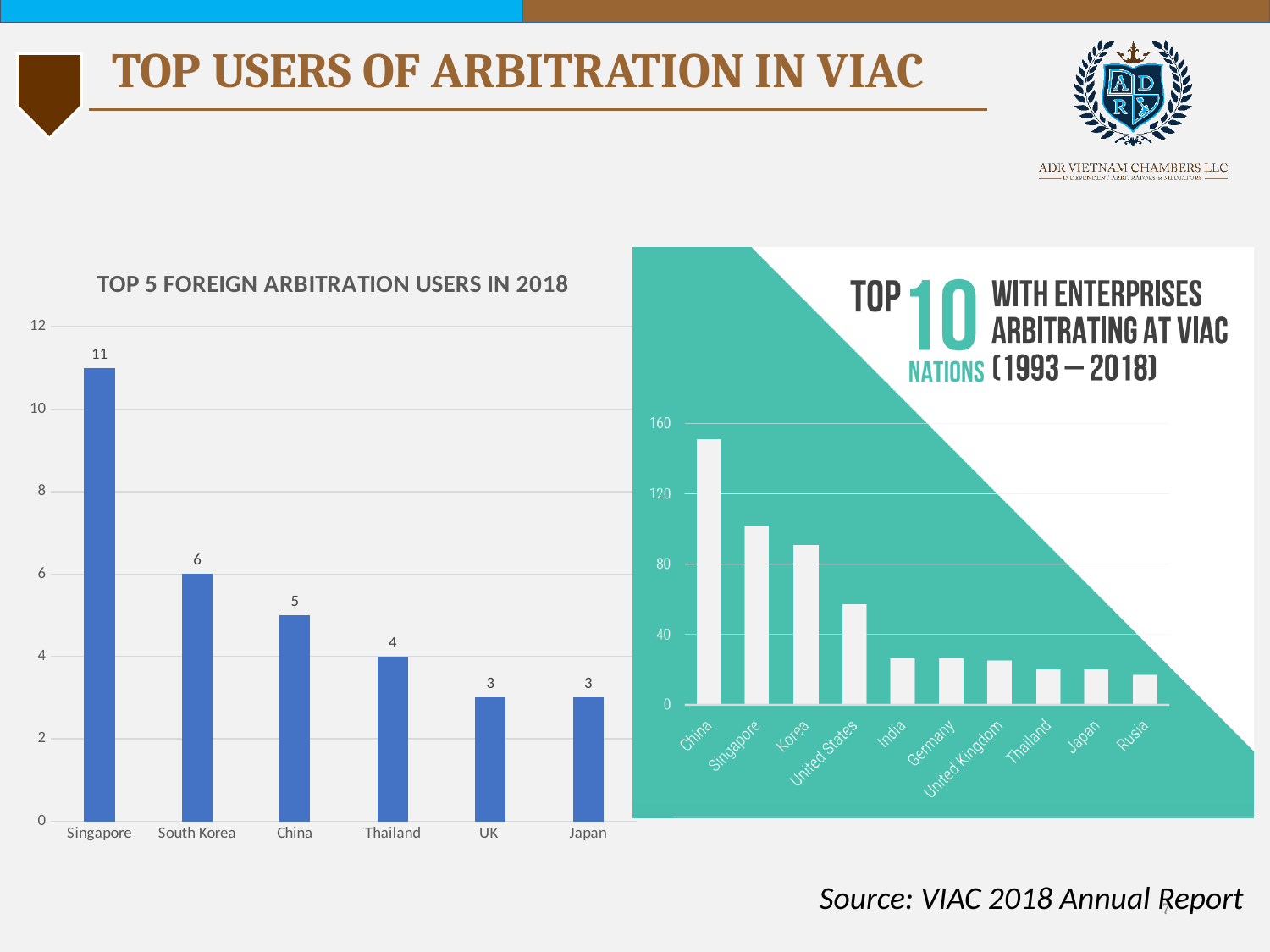
In the 'TOP 5 FOREIGN ARBITRATION USERS IN 2018' chart, which category has the highest value? Singapore How many categories are shown in the 'TOP 5 FOREIGN ARBITRATION USERS IN 2018' chart? 6 In the 'TOP 5 FOREIGN ARBITRATION USERS IN 2018' chart, what is the value for Thailand? 4 In the 'TOP 5 FOREIGN ARBITRATION USERS IN 2018' chart, what is the difference between the values for Singapore and South Korea? 5 In the 'TOP 10 NATIONS WITH ENTERPRISES ARBITRATING AT VIAC (1993 – 2018)' chart, is the value for India greater or less than 40? less In the 'TOP 10 NATIONS WITH ENTERPRISES ARBITRATING AT VIAC (1993 – 2018)' chart, which nation has the highest value? China How many nations are shown in the 'TOP 10 NATIONS WITH ENTERPRISES ARBITRATING AT VIAC (1993 – 2018)' chart? 10 What kind of chart is the 'TOP 5 FOREIGN ARBITRATION USERS IN 2018' chart? Bar chart In the 'TOP 5 FOREIGN ARBITRATION USERS IN 2018' chart, do the values rise or fall from Singapore to Japan along the x axis? Fall In the 'TOP 5 FOREIGN ARBITRATION USERS IN 2018' chart, what is the value for Singapore? 11 In the 'TOP 10 NATIONS WITH ENTERPRISES ARBITRATING AT VIAC (1993 – 2018)' chart, is the value for China greater or less than 120? greater In the 'TOP 5 FOREIGN ARBITRATION USERS IN 2018' chart, which is larger, the value for China or the value for Thailand? China